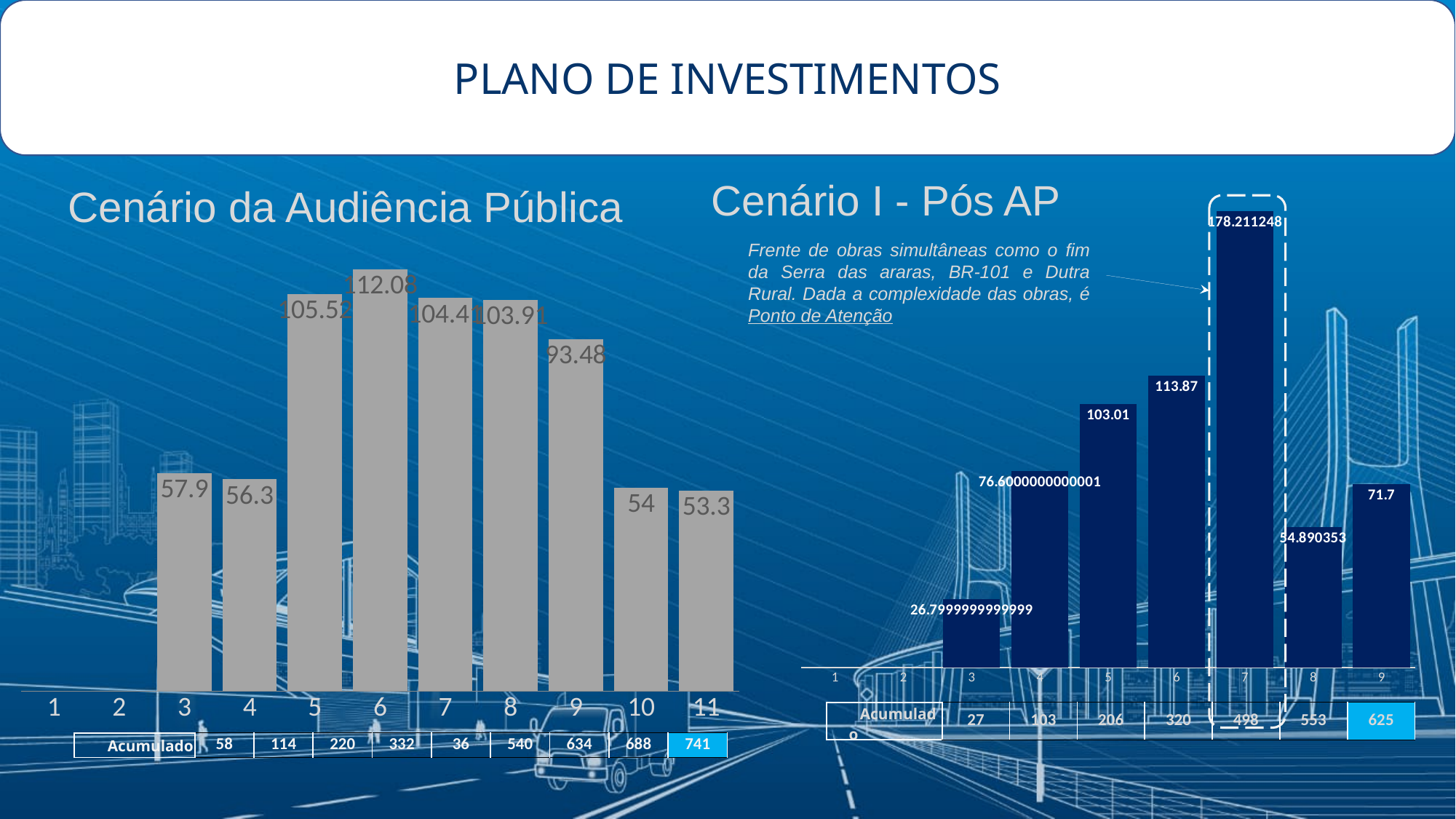
In the 'Cenário da Audiência Pública' chart, which category has the highest bar? 6 In the 'Cenário da Audiência Pública' chart, what is the difference between the values for categories 3 and 4? 1.6 In the 'Cenário da Audiência Pública' chart, what is the value for category 9? 93.48 What kind of chart is the 'Cenário da Audiência Pública' chart? bar chart In the 'Cenário I - Pós AP' chart, which category has the highest bar? 7 In the 'Cenário I - Pós AP' chart, what is the value for category 7? 178.211248 In the 'Cenário da Audiência Pública' chart, which is larger, the value for category 5 or category 7? 5 In the 'Cenário da Audiência Pública' chart, what is the value for category 6? 112.08 In the 'Cenário I - Pós AP' chart, which category has the lowest bar? 3 In the 'Cenário I - Pós AP' chart, what is the difference between the values for categories 6 and 5? 10.86 How many bars are plotted in the 'Cenário I - Pós AP' chart? 7 In the 'Cenário da Audiência Pública' chart, which category has the lowest bar? 11